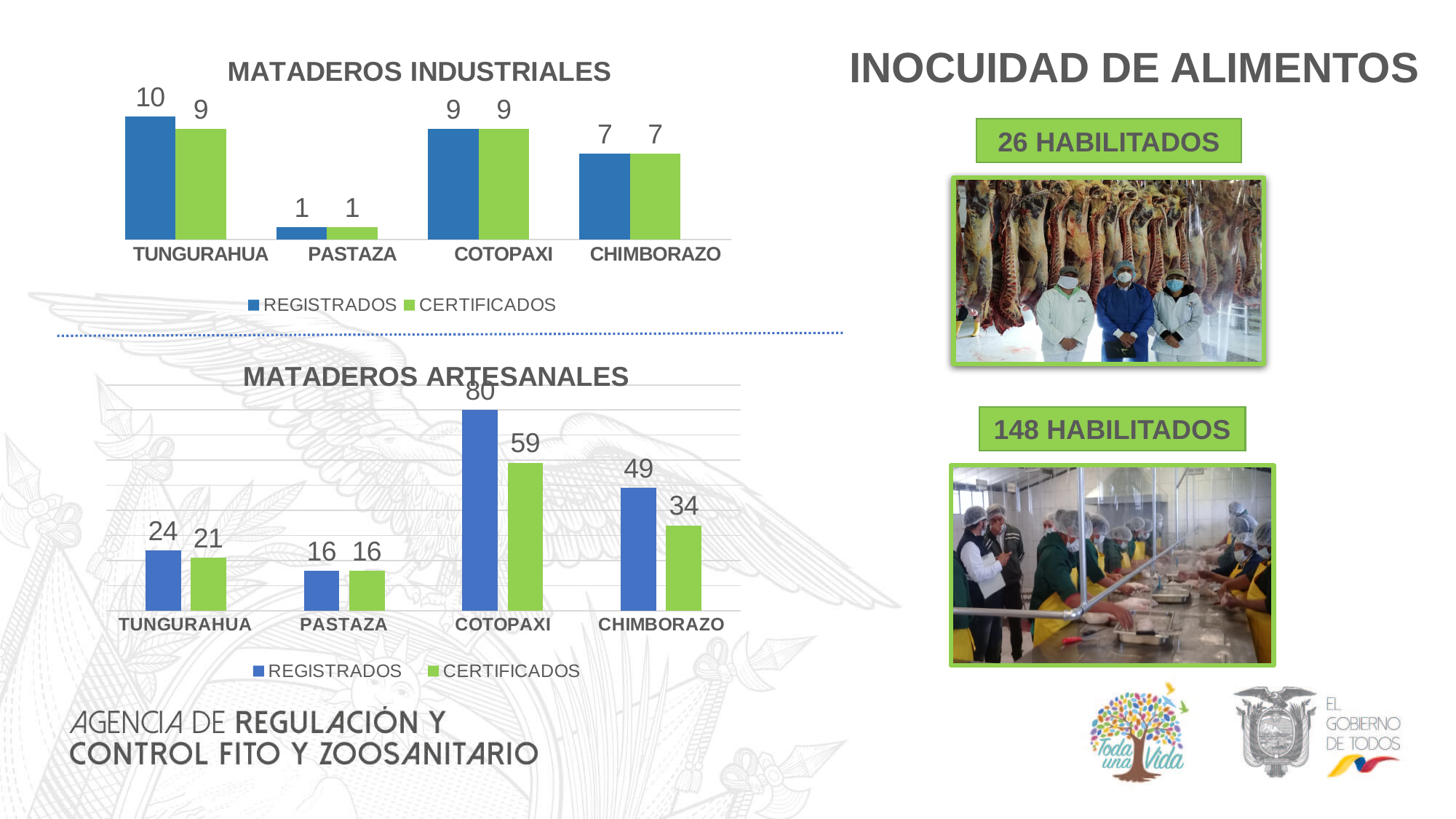
In the MATADEROS INDUSTRIALES chart, how many categories are shown on the x axis? 4 In the MATADEROS ARTESANALES chart, what is the CERTIFICADOS value for CHIMBORAZO? 34 In the MATADEROS ARTESANALES chart, what is the REGISTRADOS value for COTOPAXI? 80 In the MATADEROS INDUSTRIALES chart, what is the REGISTRADOS value for TUNGURAHUA? 10 How many series does the legend of the MATADEROS ARTESANALES chart list? 2 In the MATADEROS ARTESANALES chart, what is the difference between REGISTRADOS and CERTIFICADOS for CHIMBORAZO? 15 In the MATADEROS INDUSTRIALES chart, what is the difference between REGISTRADOS and CERTIFICADOS for TUNGURAHUA? 1 What kind of chart is the MATADEROS INDUSTRIALES chart? Bar chart In the MATADEROS ARTESANALES chart, which category has the highest CERTIFICADOS value? COTOPAXI In the MATADEROS INDUSTRIALES chart, what is the CERTIFICADOS value for COTOPAXI? 9 In the MATADEROS INDUSTRIALES chart, which category has the lowest REGISTRADOS value? PASTAZA In the MATADEROS ARTESANALES chart, which is larger, REGISTRADOS for TUNGURAHUA or REGISTRADOS for PASTAZA? TUNGURAHUA